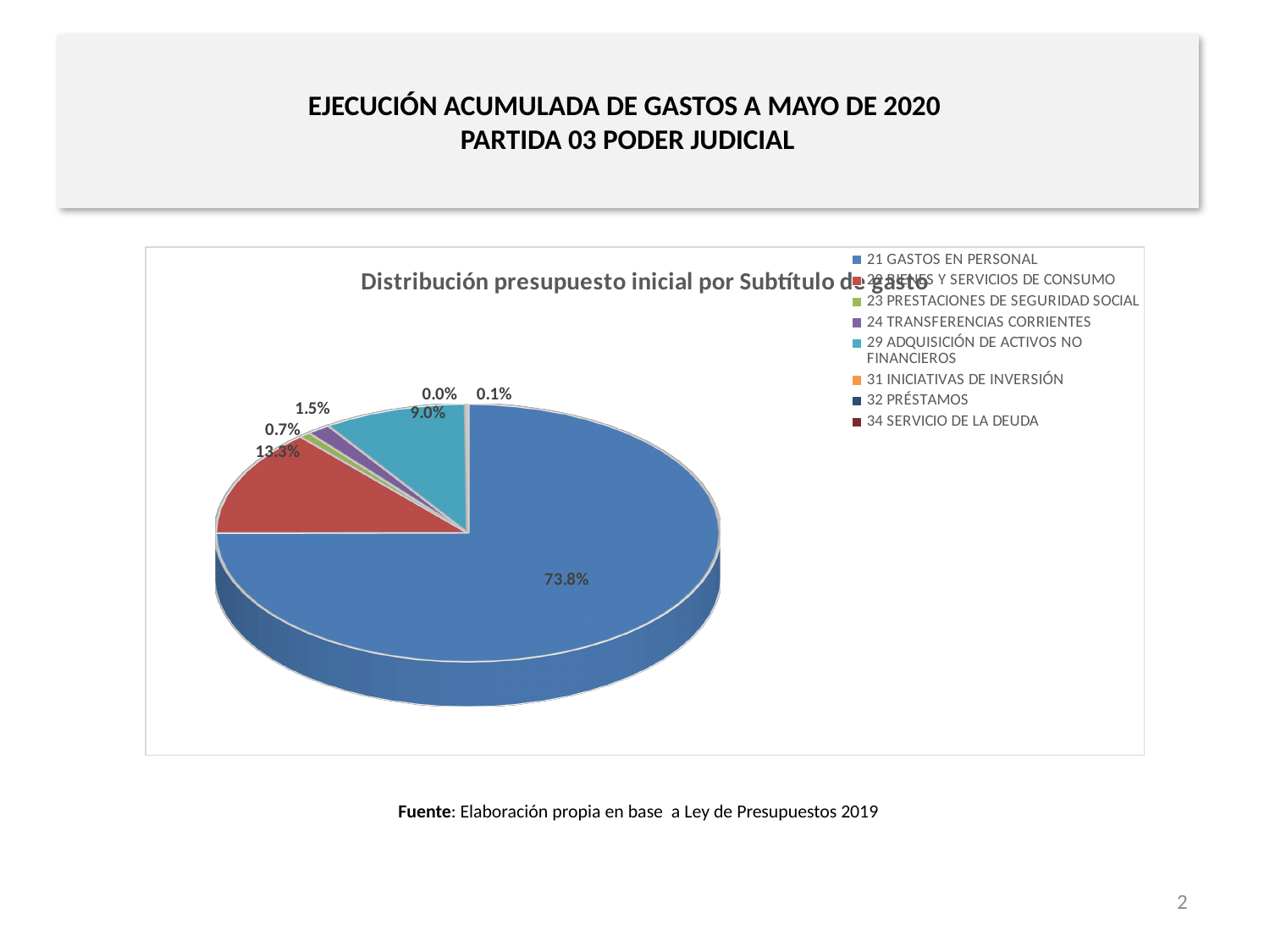
What kind of chart is shown on the slide? Pie chart Which is larger: the slice for 22 BIENES Y SERVICIOS DE CONSUMO or the slice for 29 ADQUISICIÓN DE ACTIVOS NO FINANCIEROS? 22 BIENES Y SERVICIOS DE CONSUMO What share of the pie does 23 PRESTACIONES DE SEGURIDAD SOCIAL represent? 0.7% What is the difference in percentage points between the share for 21 GASTOS EN PERSONAL and the share for 22 BIENES Y SERVICIOS DE CONSUMO? 60.5 percentage points What colour is the slice for 21 GASTOS EN PERSONAL? Blue What share of the pie does 29 ADQUISICIÓN DE ACTIVOS NO FINANCIEROS represent? 9.0% What share of the pie does 21 GASTOS EN PERSONAL represent? 73.8% Which category has the largest slice of the pie? 21 GASTOS EN PERSONAL What is the title of the chart? Distribución presupuesto inicial por Subtítulo de gasto How many entries does the chart legend list? 8